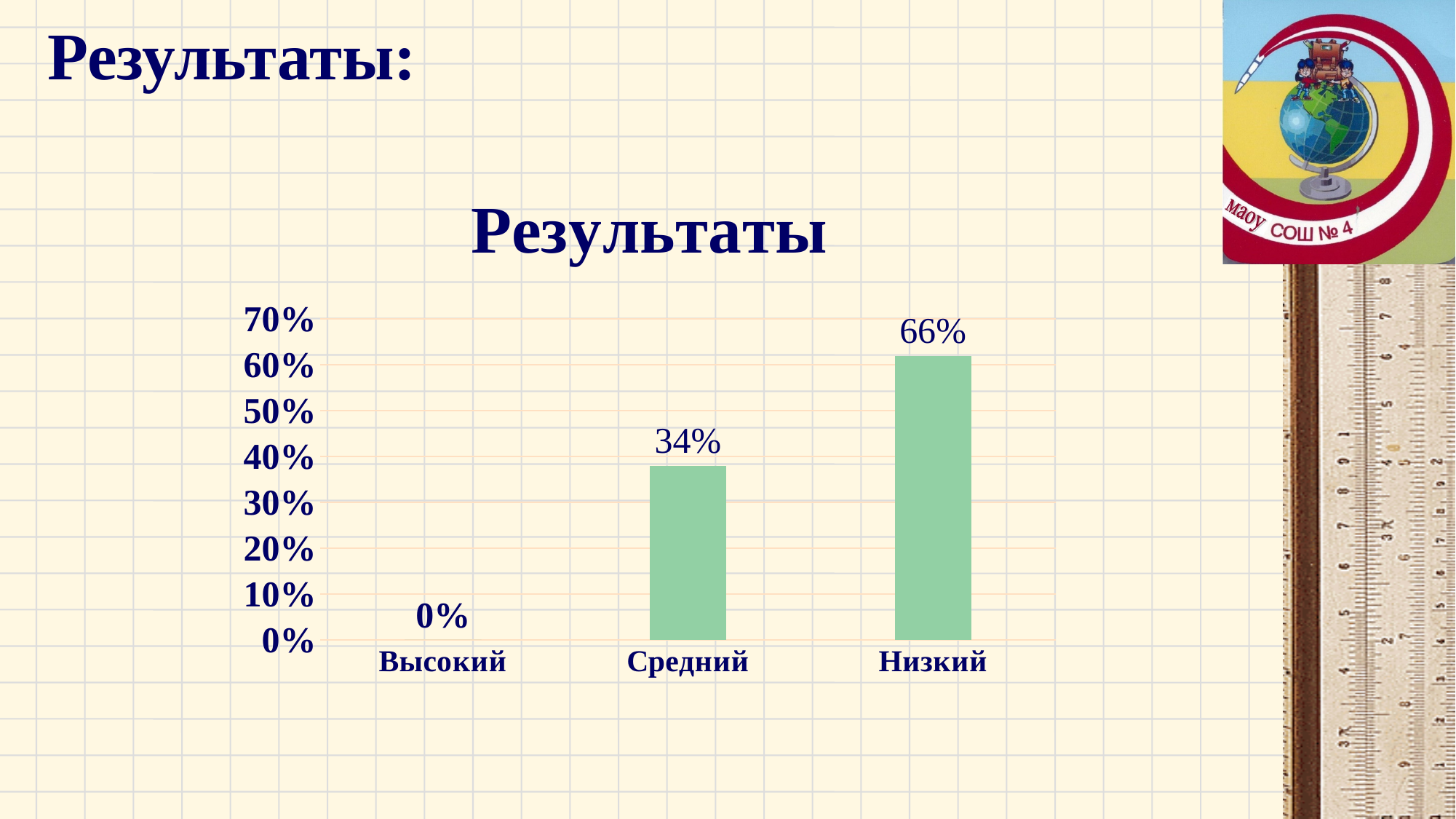
What kind of chart is shown on the slide? bar chart Which category has the highest value? Низкий What is the difference between the values for Низкий and Средний? 32% What is the value for Средний? 34% Which category has the lowest value? Высокий How many categories are shown on the x axis? 3 Is the value for Средний greater or less than 40%? less What is the value for Низкий? 66% Is the value for Низкий greater or less than 60%? greater What is the value for Высокий? 0% Which is larger, the value for Средний or the value for Низкий? Низкий What is the title of the chart? Результаты